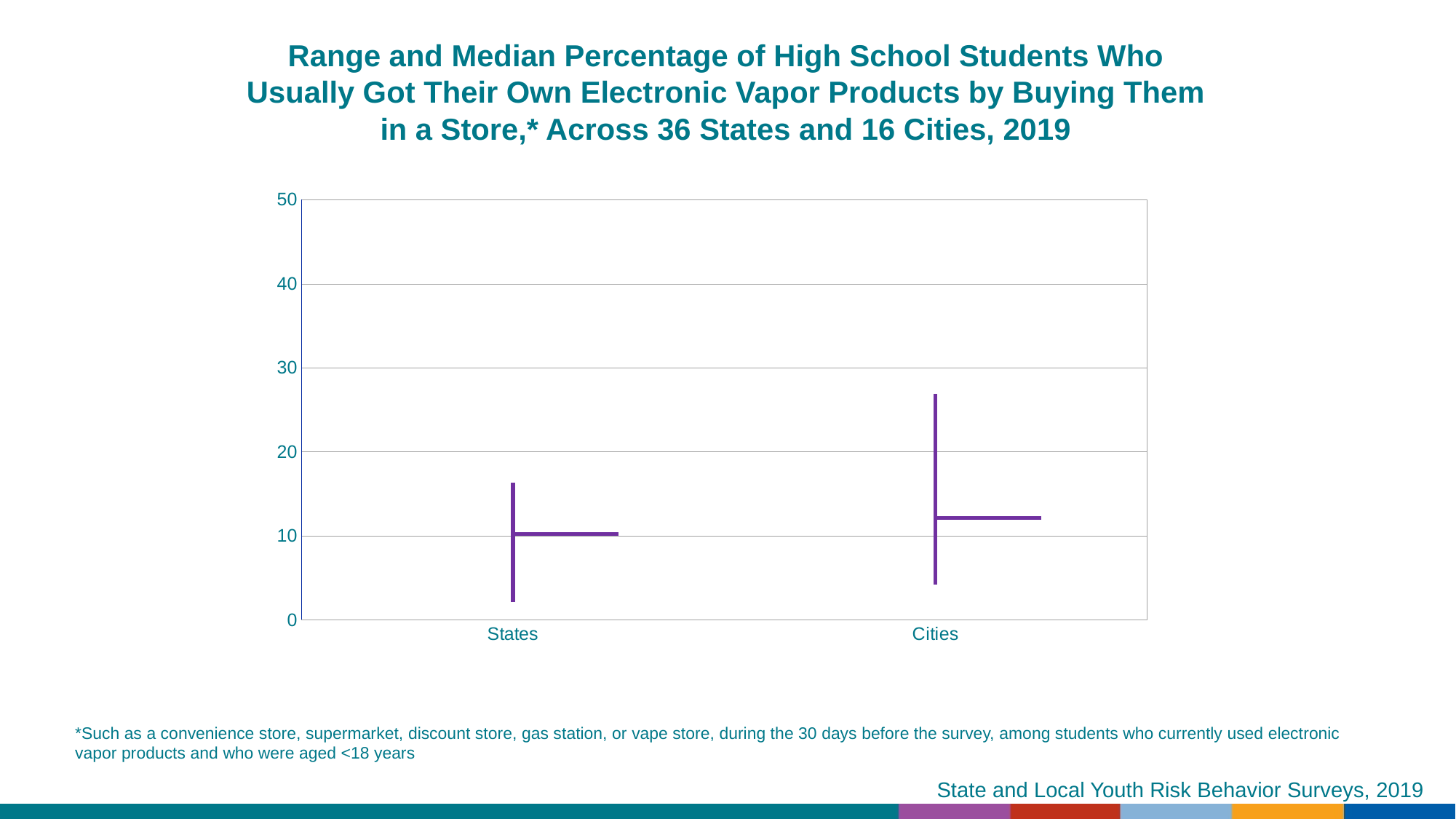
Is the top of the range for Cities greater or less than 20? greater Is the top of the range for States greater or less than 20? less Which category has the higher median value? Cities Is the median value for Cities greater or less than 10? greater What are the two categories shown on the x axis? States and Cities How many categories are shown on the x axis of the chart? 2 What is the highest value shown on the y axis? 50 Which category has the lower bottom of its range, States or Cities? States Which category has the higher top of its range, States or Cities? Cities